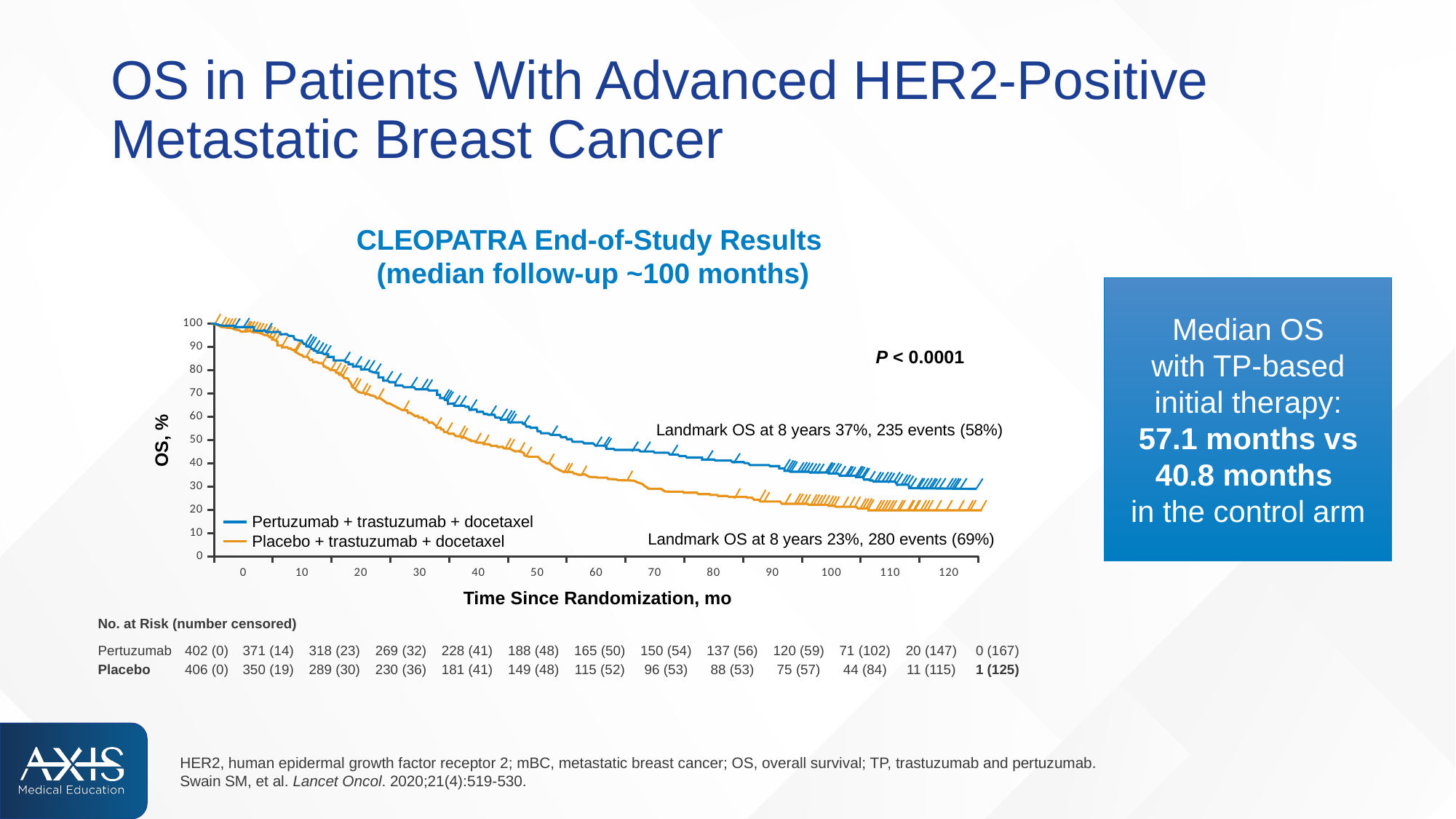
What is the difference in landmark OS at 8 years between the pertuzumab arm and the placebo arm? 14 percentage points What is the title of the x axis? Time Since Randomization, mo Is the OS value for the Pertuzumab + trastuzumab + docetaxel arm at 40 months greater or less than 50%? greater Do the OS curves rise or fall as time since randomization increases? Fall How many events (with percentage) are reported for the placebo arm? 280 events (69%) What P value is shown on the chart? P < 0.0001 What is the landmark OS at 8 years for the Placebo + trastuzumab + docetaxel arm? 23% What is the landmark OS at 8 years for the Pertuzumab + trastuzumab + docetaxel arm? 37% Which arm has the higher landmark OS at 8 years? Pertuzumab + trastuzumab + docetaxel How many treatment arms (series) does the legend list? 2 What kind of chart is shown on the slide? Line chart (Kaplan-Meier survival curve) How many patients were at risk in the Pertuzumab arm at 0 months? 402